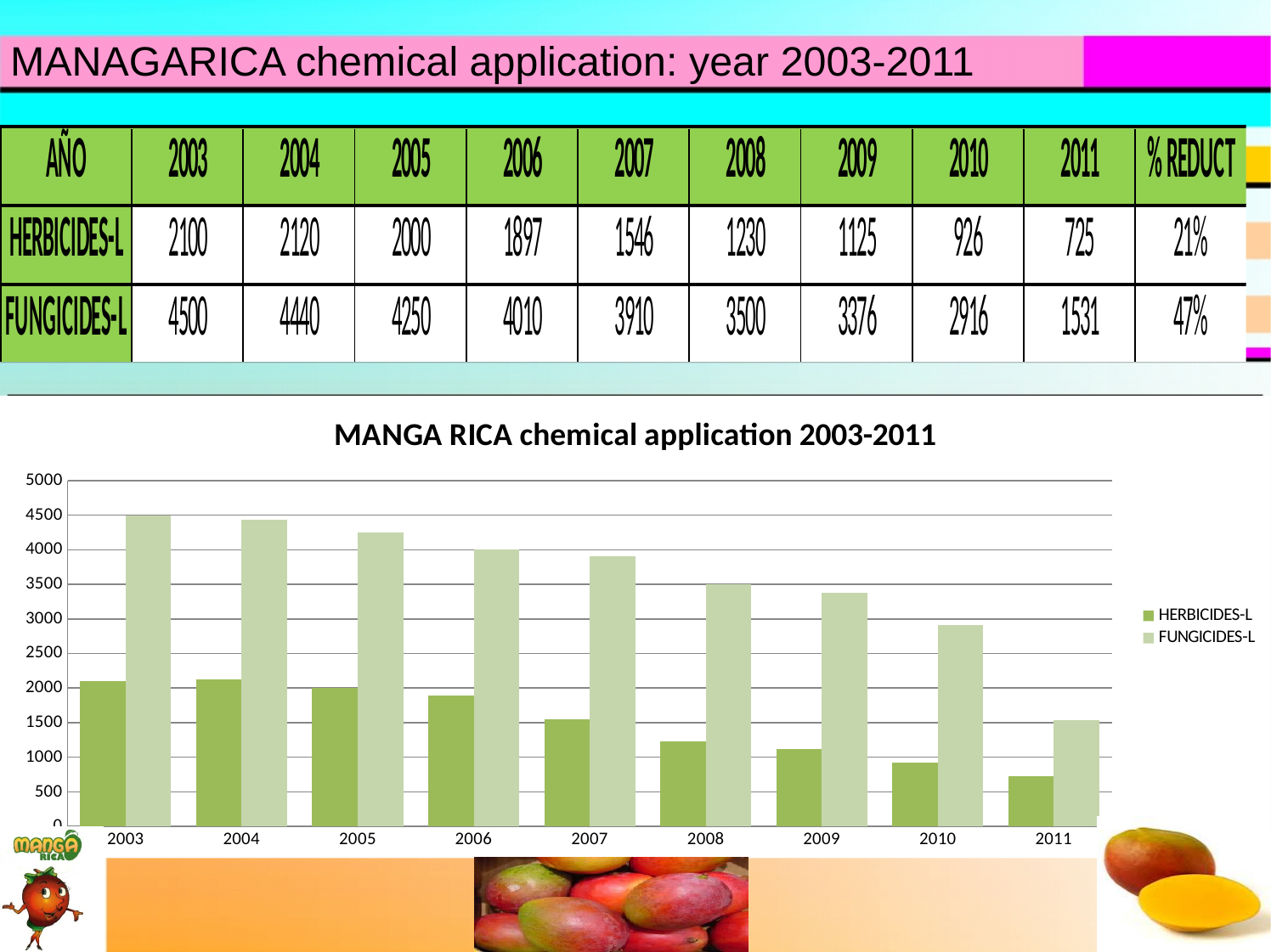
Which year has the highest FUNGICIDES-L value? 2003 What is the HERBICIDES-L value for 2011? 725 What is the FUNGICIDES-L value for 2003? 4500 Which year has the lowest HERBICIDES-L value? 2011 Do the FUNGICIDES-L values generally rise or fall from 2003 to 2011? fall How many years are shown on the x axis of the chart? 9 What kind of chart is shown on the slide? bar chart What is the title of the chart? MANGA RICA chemical application 2003-2011 Is the FUNGICIDES-L value for 2009 greater or less than 3000? greater How many series does the chart legend list? 2 What is the difference between the FUNGICIDES-L and HERBICIDES-L values in 2008? 2270 Which is larger in 2010, the HERBICIDES-L value or the FUNGICIDES-L value? FUNGICIDES-L